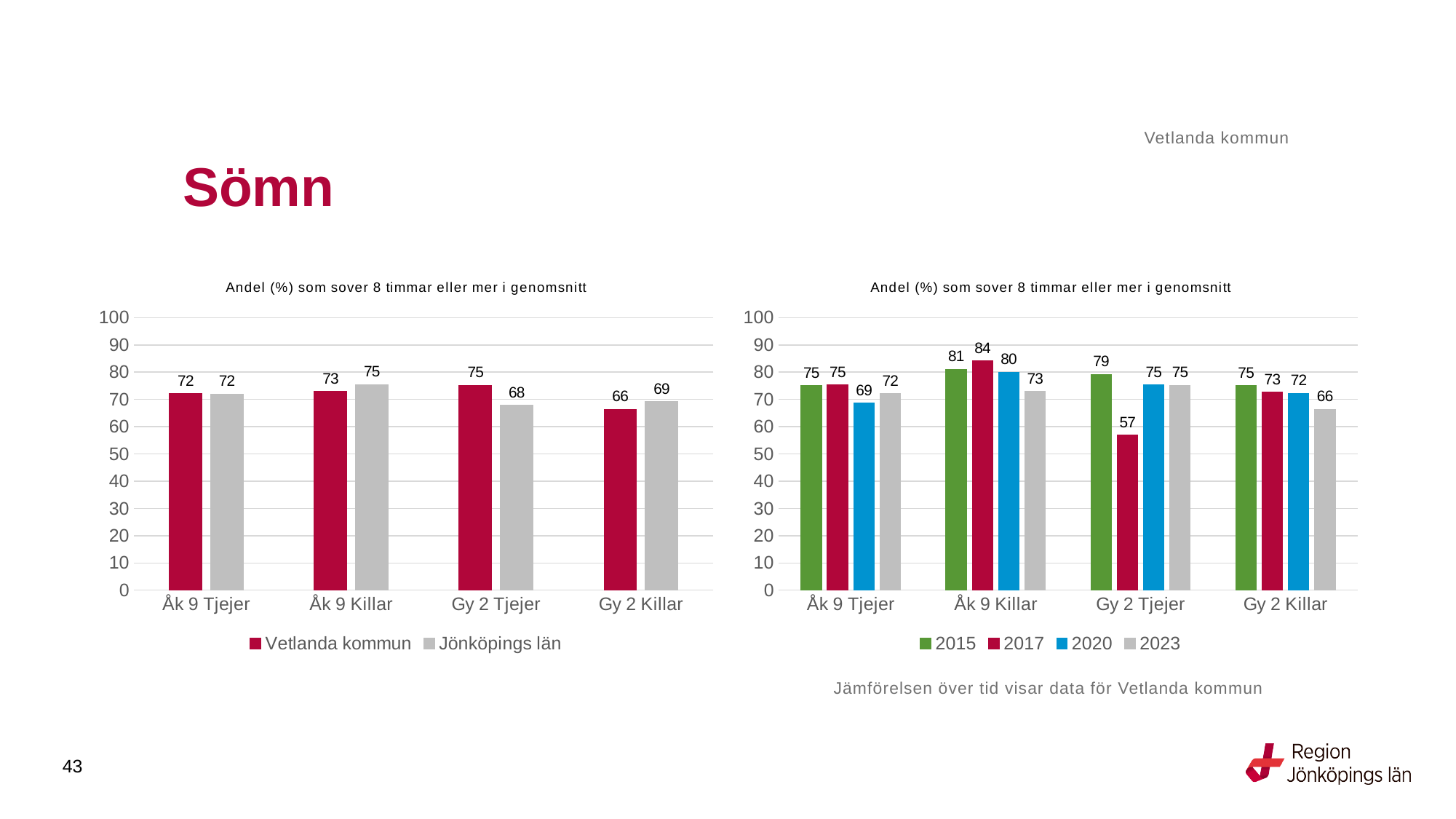
In the left chart, what is the value for Jönköpings län for Gy 2 Killar? 69 In the right chart, what is the value for 2020 for Åk 9 Killar? 80 In the left chart, how many series does the legend list? 2 In the right chart, what is the difference between the 2015 and 2017 values for Gy 2 Tjejer? 22 In the left chart, what is the difference between Vetlanda kommun and Jönköpings län for Gy 2 Tjejer? 7 In the right chart, is the value for 2015 for Gy 2 Tjejer larger or smaller than the value for 2023 for Gy 2 Tjejer? larger In the right chart, how many series does the legend list? 4 In the left chart, which category has the lowest value for Vetlanda kommun? Gy 2 Killar In the right chart, what is the value for 2017 for Gy 2 Tjejer? 57 In the left chart, what is the value for Vetlanda kommun for Gy 2 Tjejer? 75 In the right chart, which year has the highest value for Åk 9 Killar? 2017 What kind of chart is the right chart? bar chart